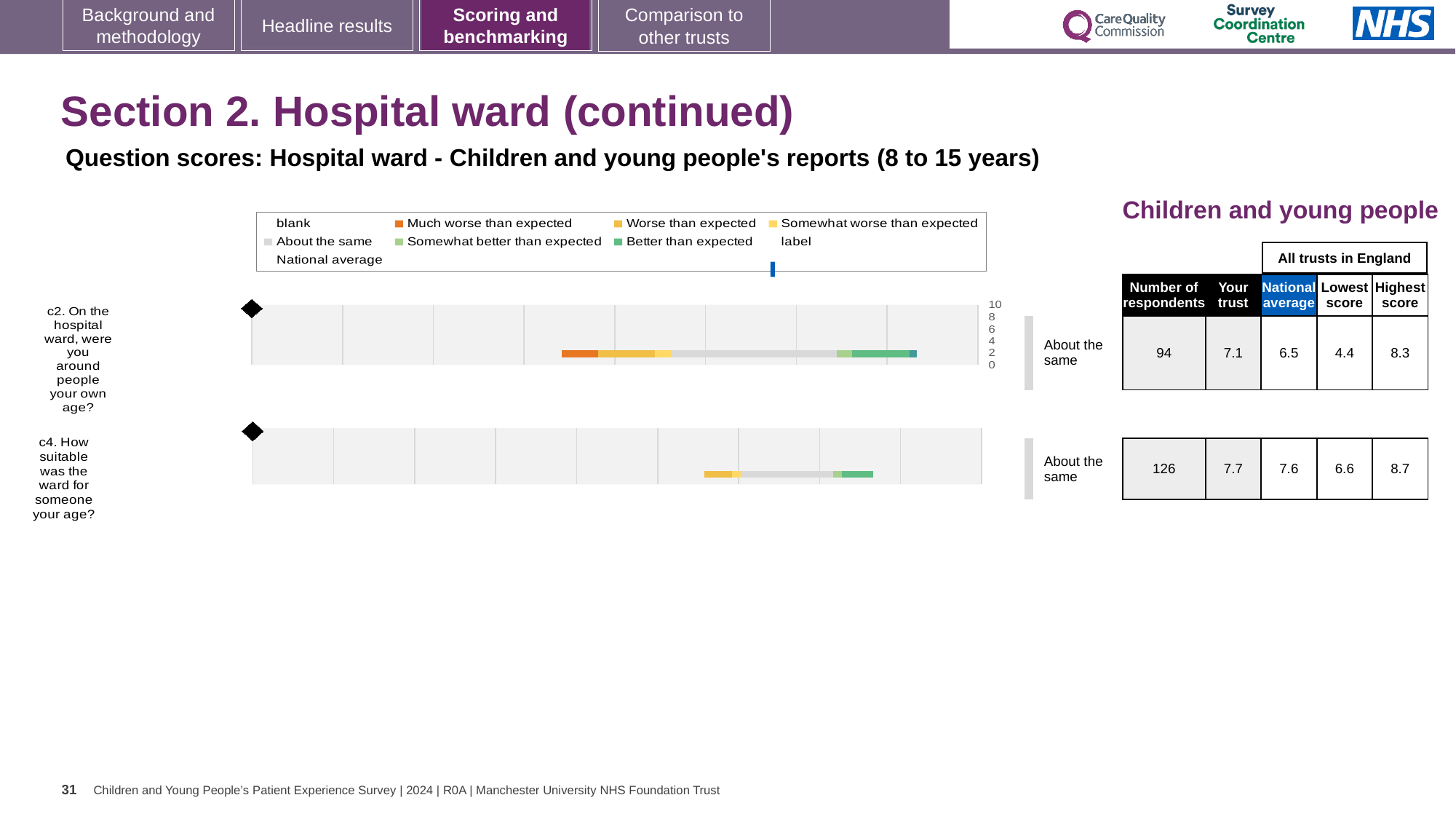
What is the highest score among all trusts in England for question c4? 8.7 Which question has the higher 'Your trust' score, c2 or c4? c4 What is the lowest score among all trusts in England for question c2? 4.4 How many questions (categories) are plotted in the chart on this slide? 2 What is the number of respondents for question c2 (On the hospital ward, were you around people your own age?)? 94 What kind of chart is used to show the question scores on this slide? Bar chart What benchmark category is shown for question c4? About the same What is the national average score for question c2? 6.5 What is the 'Your trust' score for question c4 (How suitable was the ward for someone your age?)? 7.7 Which question has more respondents, c2 or c4? c4 In the legend, which category is shown in orange? Much worse than expected What is the difference between the 'Your trust' score and the national average for question c2? 0.6